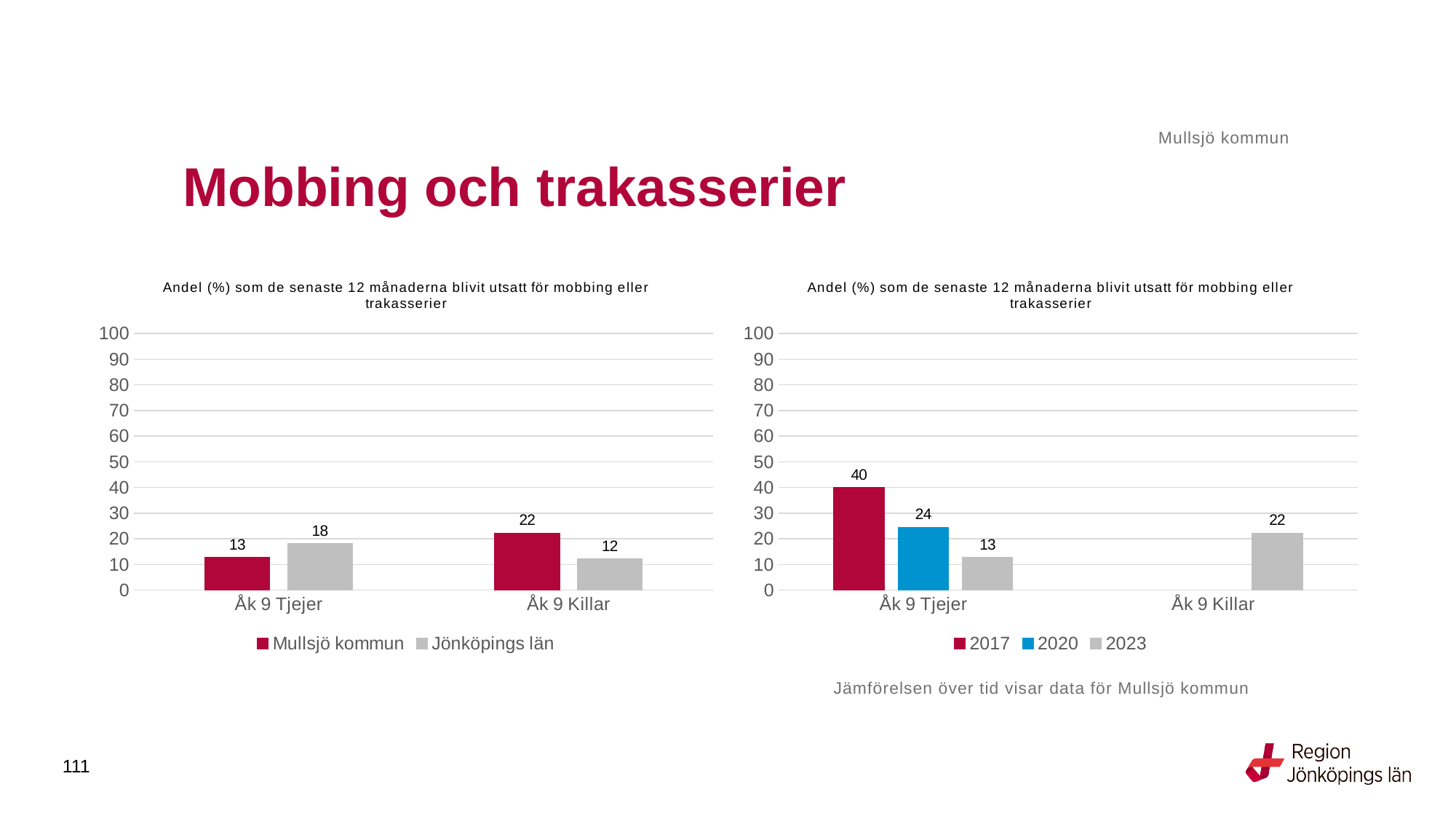
What kind of chart is the right chart? Bar chart In the right chart, which year has the highest value for Åk 9 Tjejer? 2017 In the right chart, what is the difference between the 2017 and 2023 values for Åk 9 Tjejer? 27 In the left chart, what is the value for Jönköpings län for Åk 9 Killar? 12 In the right chart, what is the value for 2017 for Åk 9 Tjejer? 40 In the left chart, what is the difference between Jönköpings län and Mullsjö kommun for Åk 9 Tjejer? 5 In the left chart, what is the value for Mullsjö kommun for Åk 9 Tjejer? 13 How many series does the legend of the left chart list? 2 In the right chart, what is the value for 2020 for Åk 9 Tjejer? 24 In the right chart, what is the value for 2023 for Åk 9 Killar? 22 How many series does the legend of the right chart list? 3 In the left chart, which series has the higher value for Åk 9 Killar, Mullsjö kommun or Jönköpings län? Mullsjö kommun